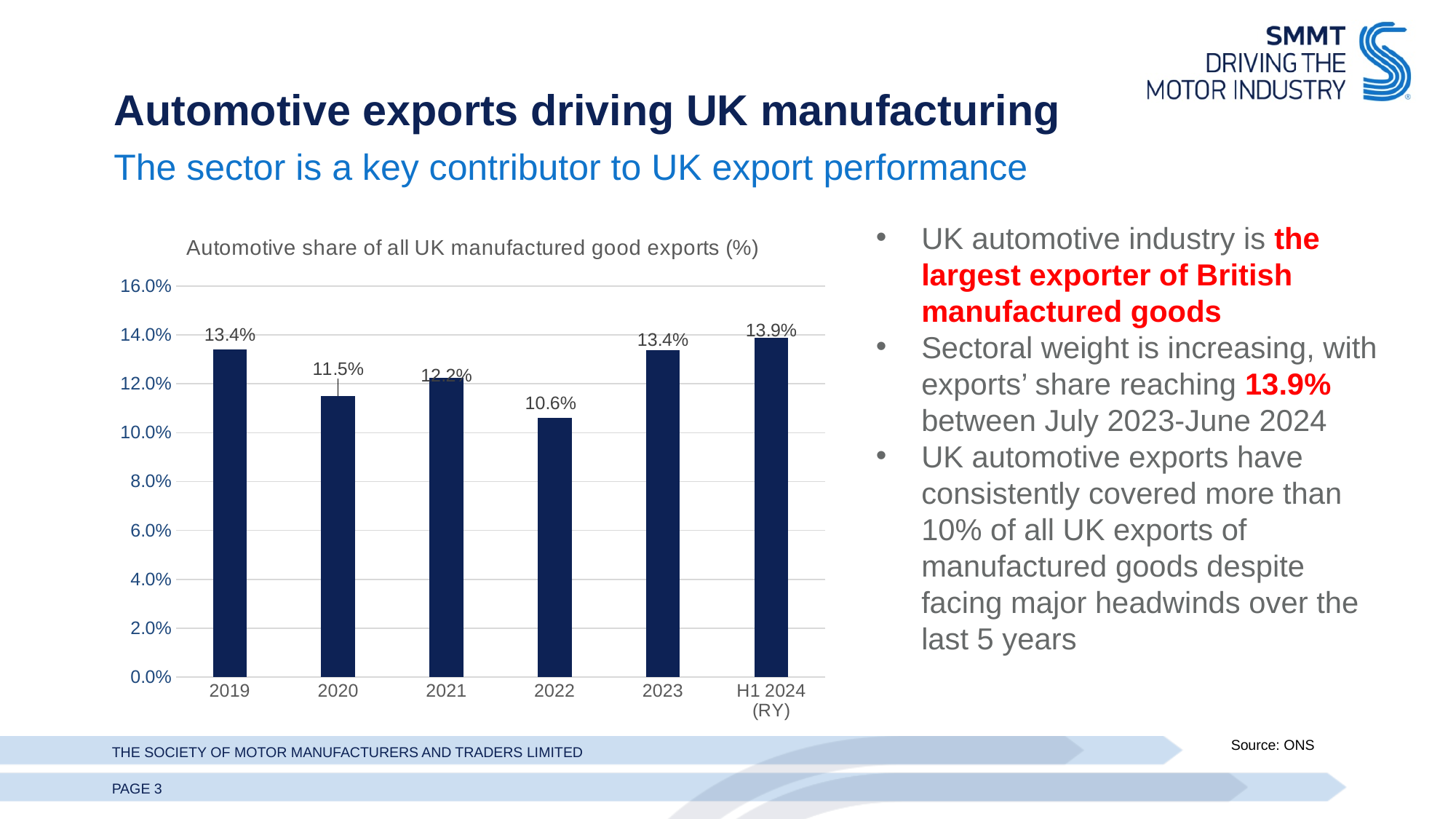
What is the difference between the automotive export share in H1 2024 (RY) and in 2022? 3.3% What is the title of the chart? Automotive share of all UK manufactured good exports (%) How many periods are shown on the x axis of the chart? 6 What is the automotive share of all UK manufactured good exports in 2019? 13.4% What kind of chart is used to show the automotive share of UK manufactured good exports? bar chart Is the automotive export share in 2022 greater or less than 12.0%? less Which period has the highest automotive share of UK manufactured good exports? H1 2024 (RY) What is the automotive share of all UK manufactured good exports in 2020? 11.5% What is the automotive share of all UK manufactured good exports in H1 2024 (RY)? 13.9% Which is larger, the automotive export share in 2020 or in 2021? 2021 Which year has the lowest automotive share of UK manufactured good exports? 2022 What is the automotive share of all UK manufactured good exports in 2022? 10.6%